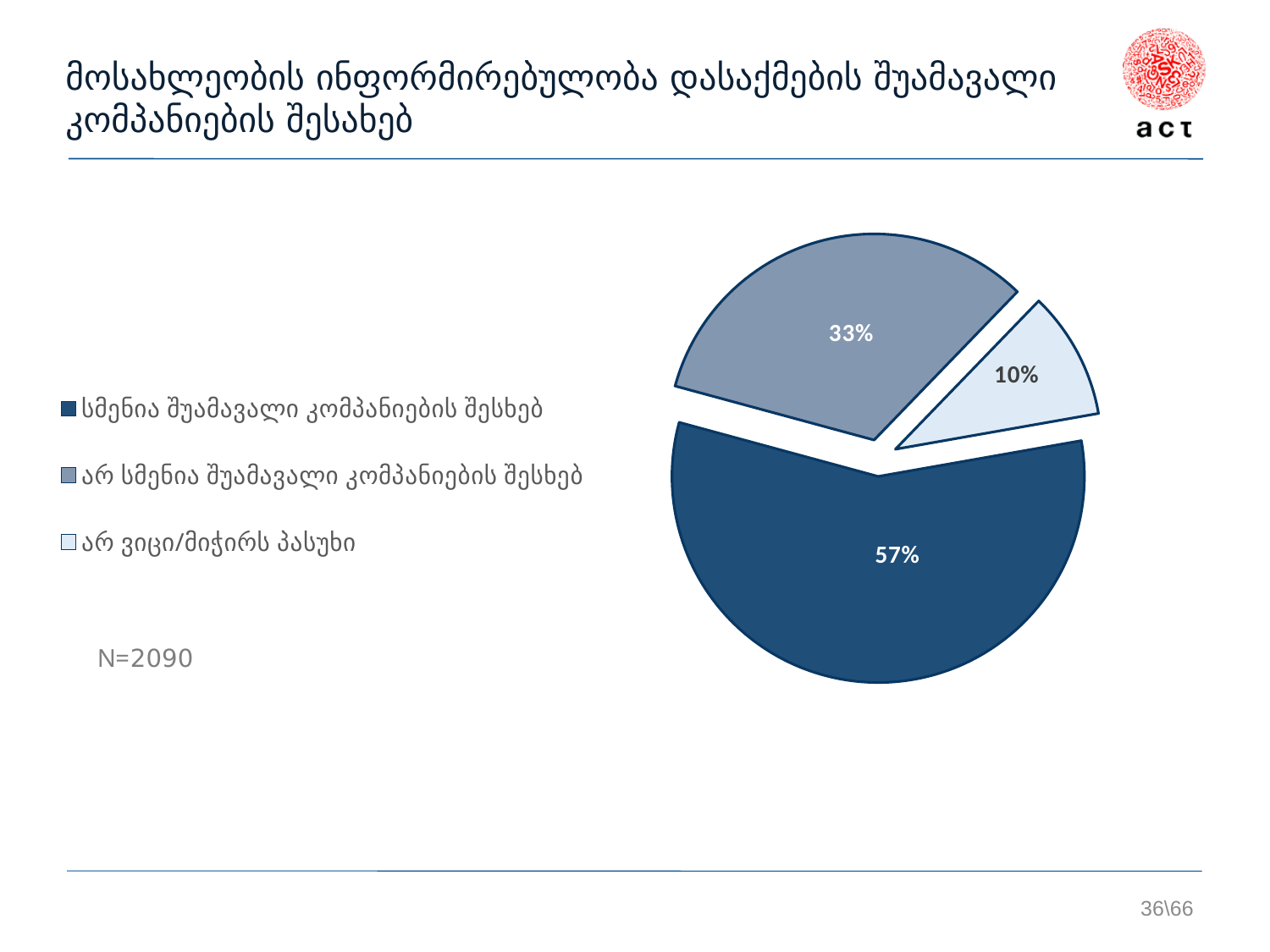
How many entries does the legend list? 3 What share of the pie is labelled for "არ სმენია შუამავალი კომპანიების შესახებ"? 33% Which category has the smallest slice of the pie? არ ვიცი/მიჭირს პასუხი Which category has the largest slice of the pie? სმენია შუამავალი კომპანიების შესხებ What is the sample size (N) shown on the slide? N=2090 What kind of chart is shown on the slide? pie chart How many slices does the pie chart have? 3 Which is larger: the "არ სმენია შუამავალი კომპანიების შესახებ" slice or the "არ ვიცი/მიჭირს პასუხი" slice? არ სმენია შუამავალი კომპანიების შესხებ What colour is the slice labelled 57%? dark blue What share of the pie is labelled for "არ ვიცი/მიჭირს პასუხი"? 10% What share of the pie is labelled for "სმენია შუამავალი კომპანიების შესახებ"? 57% What is the difference in percentage points between the "სმენია შუამავალი კომპანიების შესახებ" slice and the "არ სმენია შუამავალი კომპანიების შესახებ" slice? 24 percentage points